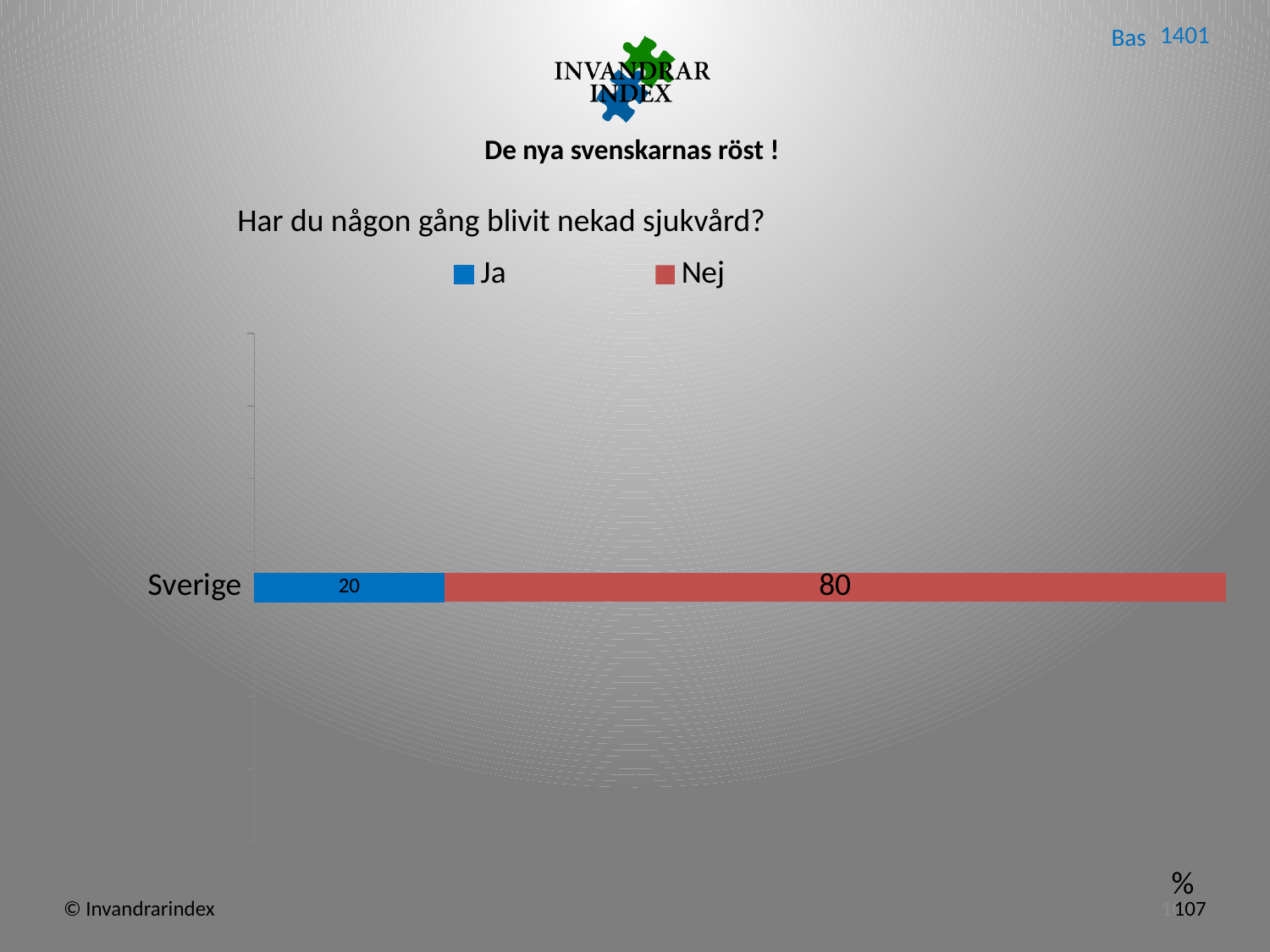
What kind of chart is shown on the slide? Stacked bar chart What is the difference between the Nej and Ja values for Sverige? 60 What is the value for Ja for Sverige? 20 What is the total of the stacked bar for Sverige? 100 How many categories are plotted on the chart? 1 What is the title of the chart? Har du någon gång blivit nekad sjukvård? What is the value for Nej for Sverige? 80 Which colour represents the Nej series in the chart? Red What is the name of the single category shown on the chart? Sverige How many series does the legend list? 2 Which series has the larger value for Sverige, Ja or Nej? Nej